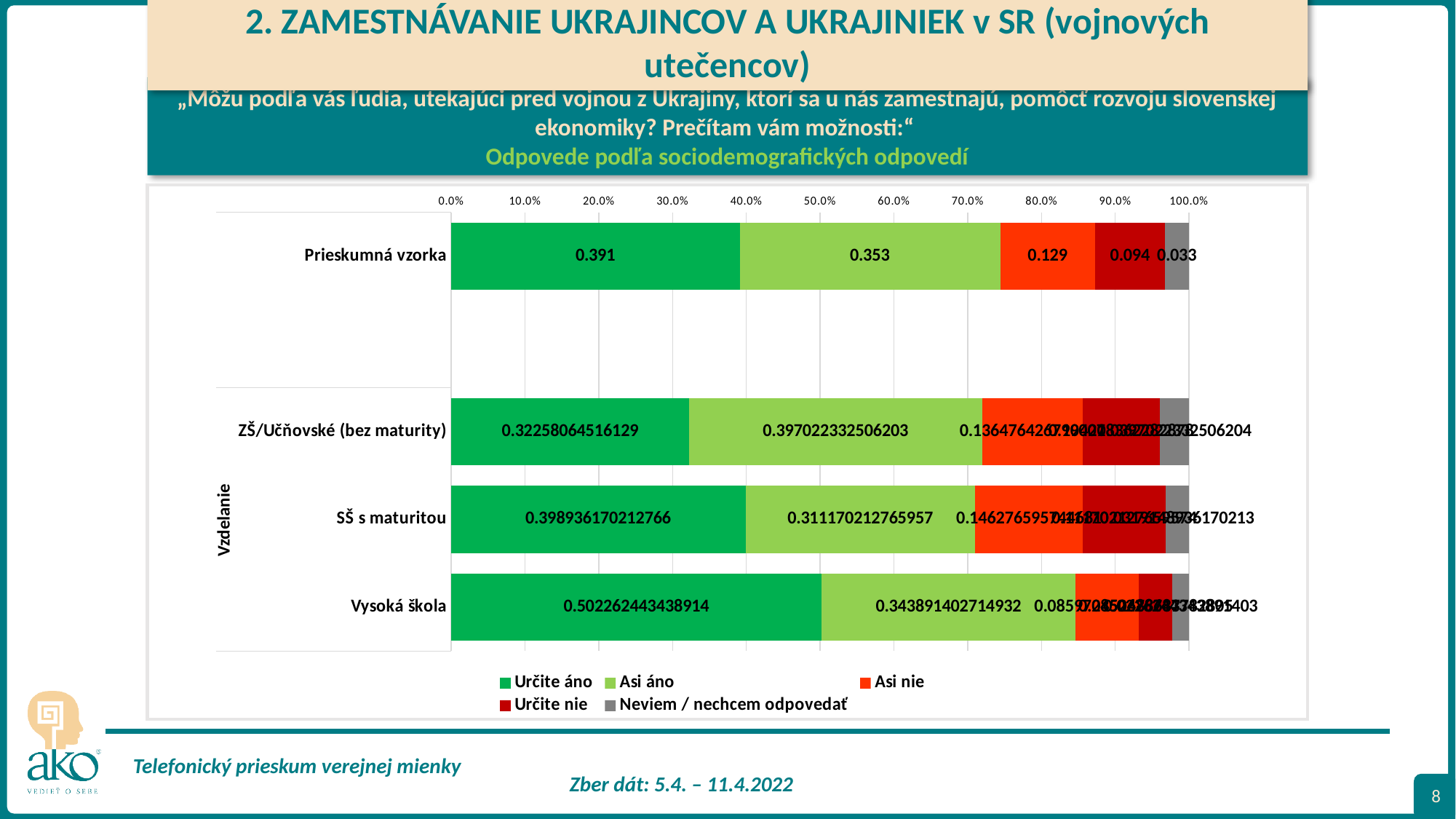
How many series does the legend list? 5 What is the value of "Asi áno" for SŠ s maturitou? 0.311170212765957 What kind of chart is shown on the slide? Stacked bar chart What is the value of "Neviem / nechcem odpovedať" for Prieskumná vzorka? 0.033 Which is larger for ZŠ/Učňovské (bez maturity): "Určite áno" or "Asi áno"? Asi áno What is the value of "Určite áno" for Vysoká škola? 0.502262443438914 What is the value of "Asi nie" for Prieskumná vzorka? 0.129 Is the value of "Určite áno" for Vysoká škola greater or less than 40.0%? greater What is the value of "Určite áno" for Prieskumná vzorka? 0.391 Which category has the lowest value for "Určite áno"? ZŠ/Učňovské (bez maturity) Which category has the highest value for "Určite áno"? Vysoká škola What is the difference between "Určite áno" and "Asi áno" for Prieskumná vzorka? 0.038